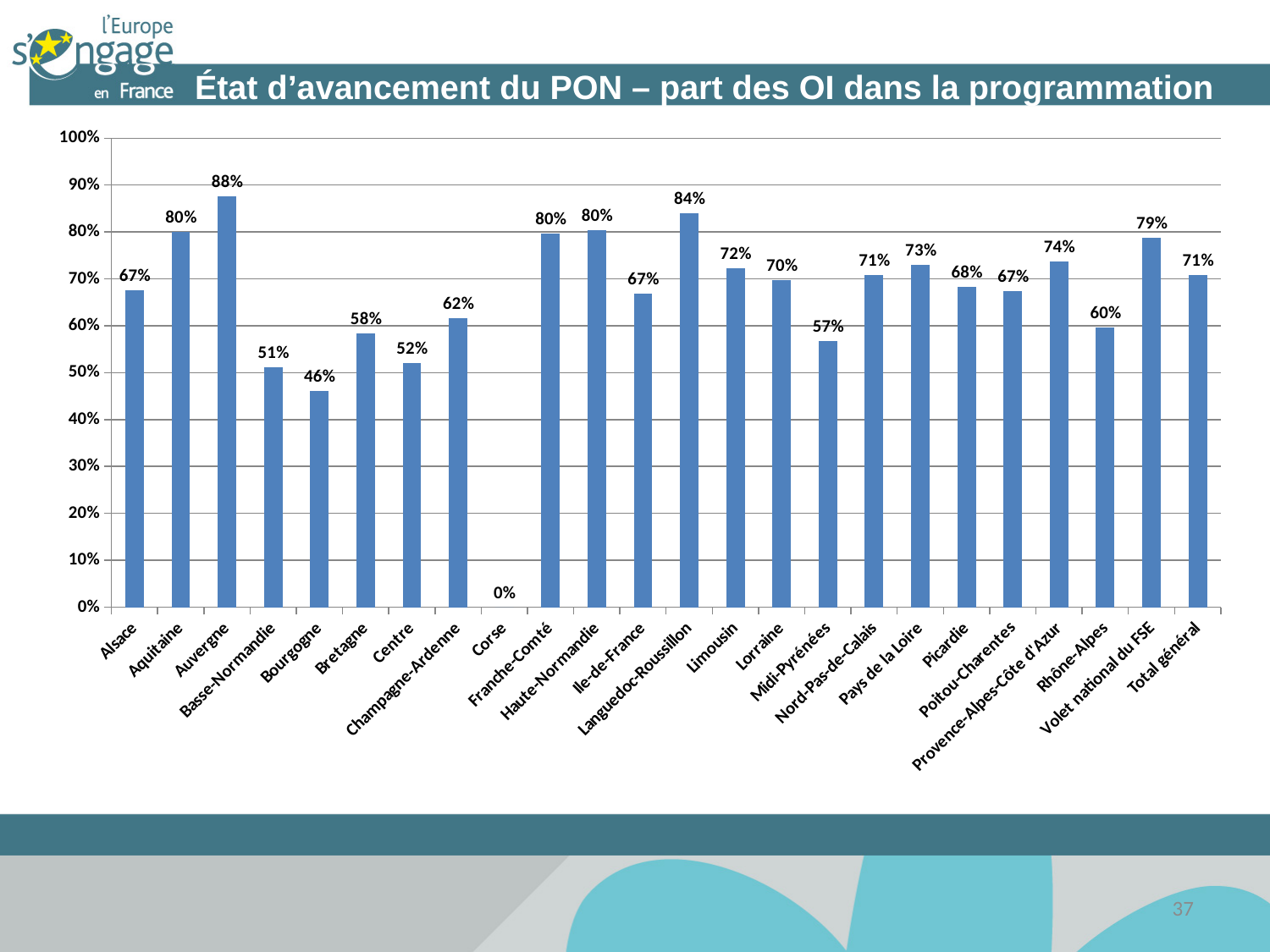
What is the value for Auvergne? 88% What kind of chart is shown on the slide? bar chart What is the value for Languedoc-Roussillon? 84% How many categories are shown on the x axis? 24 What is the value for Total général? 71% What is the difference between the values for Auvergne and Bourgogne? 42% Which category has the lowest value? Corse What is the title of the slide? État d'avancement du PON – part des OI dans la programmation What is the value for Bourgogne? 46% Which is larger, the value for Midi-Pyrénées or the value for Rhône-Alpes? Rhône-Alpes Which category has the highest value? Auvergne Is the value for Volet national du FSE greater or less than 70%? greater